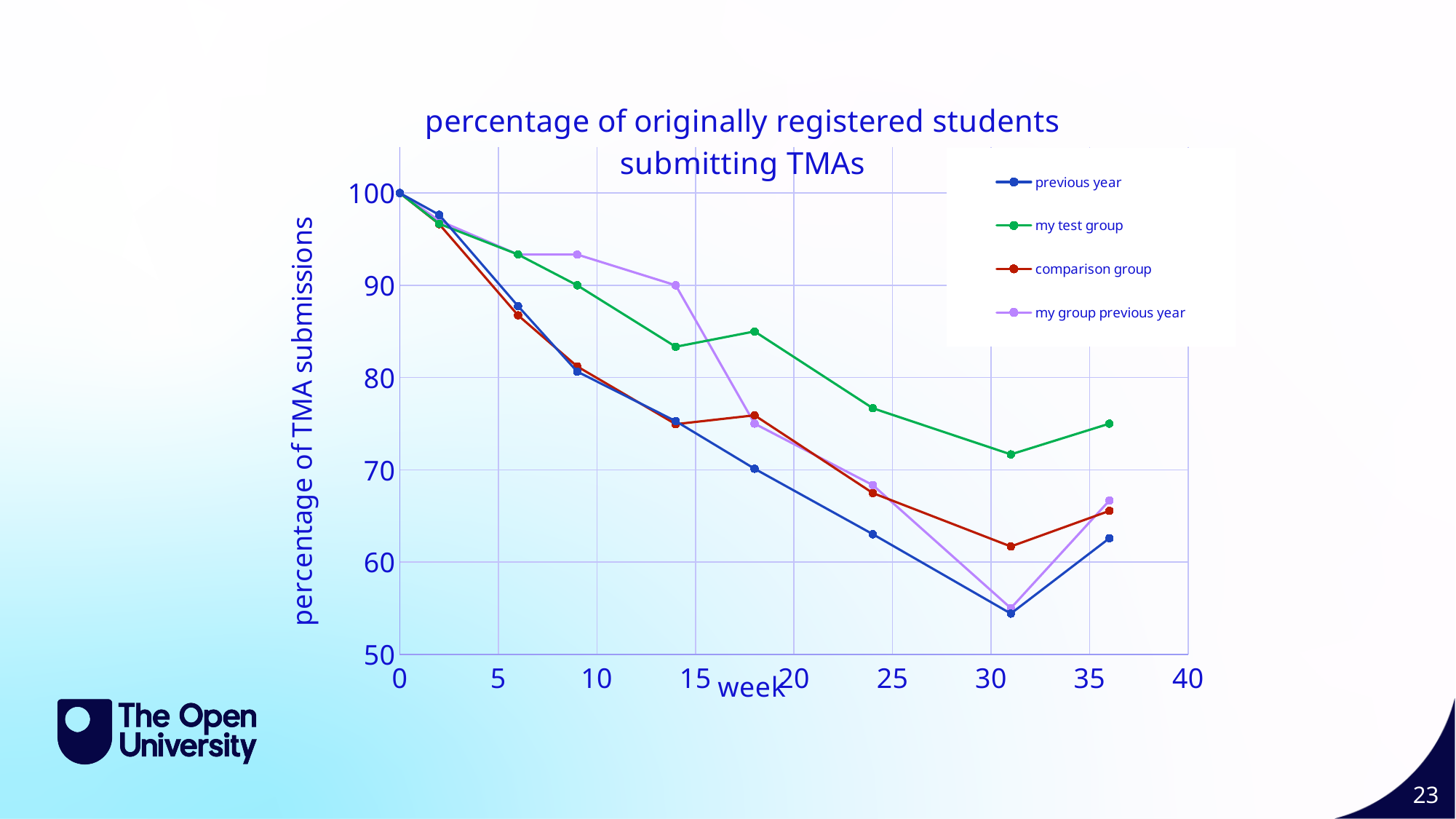
What is the title of the chart? percentage of originally registered students submitting TMAs Does the previous year series rise or fall from week 0 to week 31? fall Which series has the highest value at week 36? my test group Is the value for previous year at week 31 greater or less than 60? less At week 14, which is larger: my test group or comparison group? my test group What kind of chart is shown on the slide? line chart What is the label of the vertical axis? percentage of TMA submissions How many data points does the my test group series have? 9 Is the value for my test group at week 31 greater or less than 70? greater How many series does the legend list? 4 Is the value for comparison group at week 24 greater or less than 70? less What is the value for every series at week 0? 100